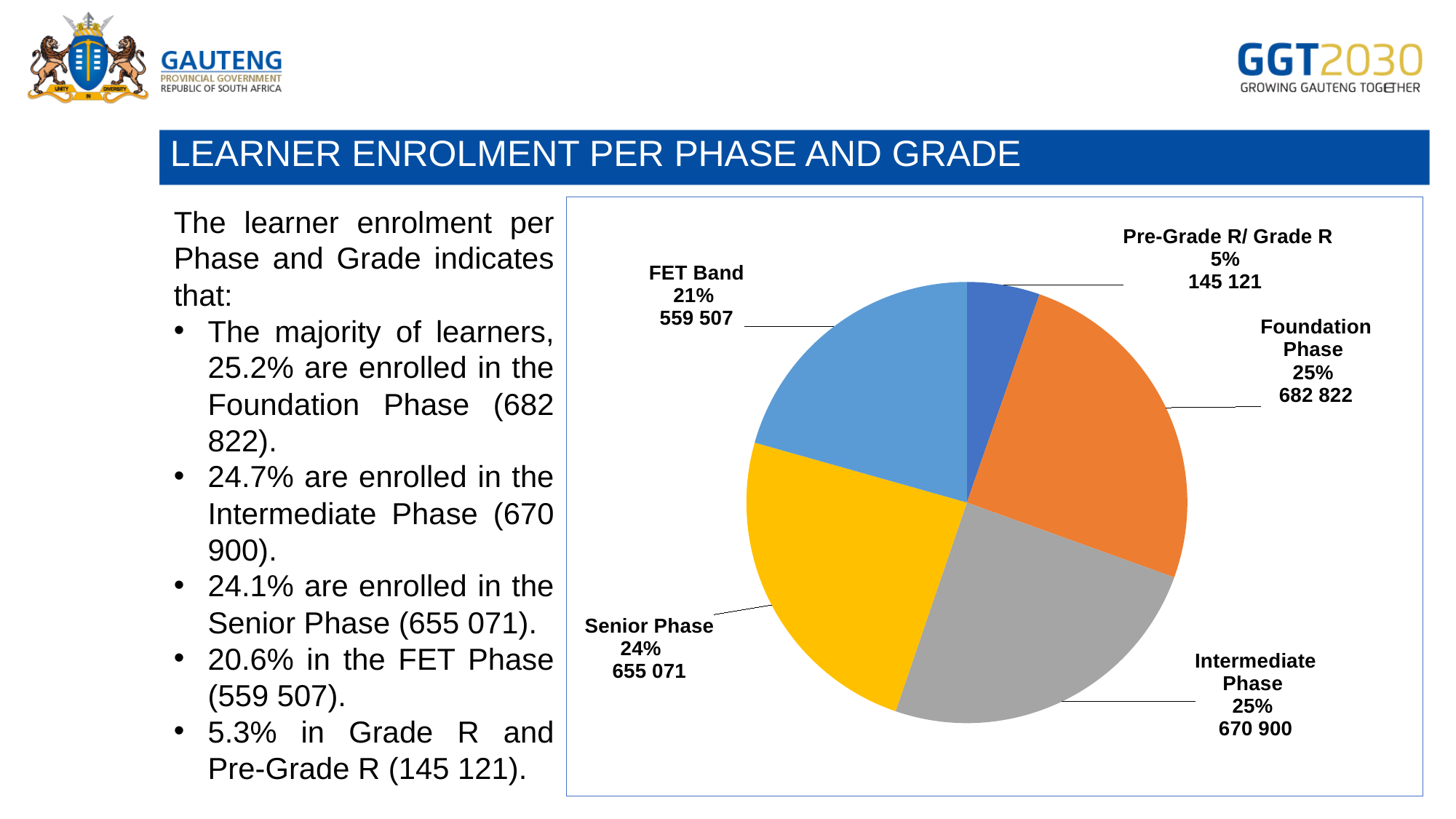
How many slices does the pie chart have? 5 What percentage share of the pie does the FET Band represent? 21% What is the difference in enrolment between the Senior Phase and the FET Band? 95 564 What type of chart is shown on the slide? Pie chart Which phase has the largest enrolment in the pie chart? Foundation Phase What is the enrolment value shown for the Pre-Grade R/ Grade R slice? 145 121 What is the enrolment value shown for the FET Band slice? 559 507 Which slice of the pie chart has the smallest enrolment? Pre-Grade R/ Grade R What is the difference in enrolment between the Foundation Phase and the Intermediate Phase? 11 922 What is the learner enrolment value shown for the Foundation Phase slice? 682 822 Which has the larger enrolment, the Senior Phase or the FET Band? Senior Phase What percentage share of the pie does the Intermediate Phase represent? 25%